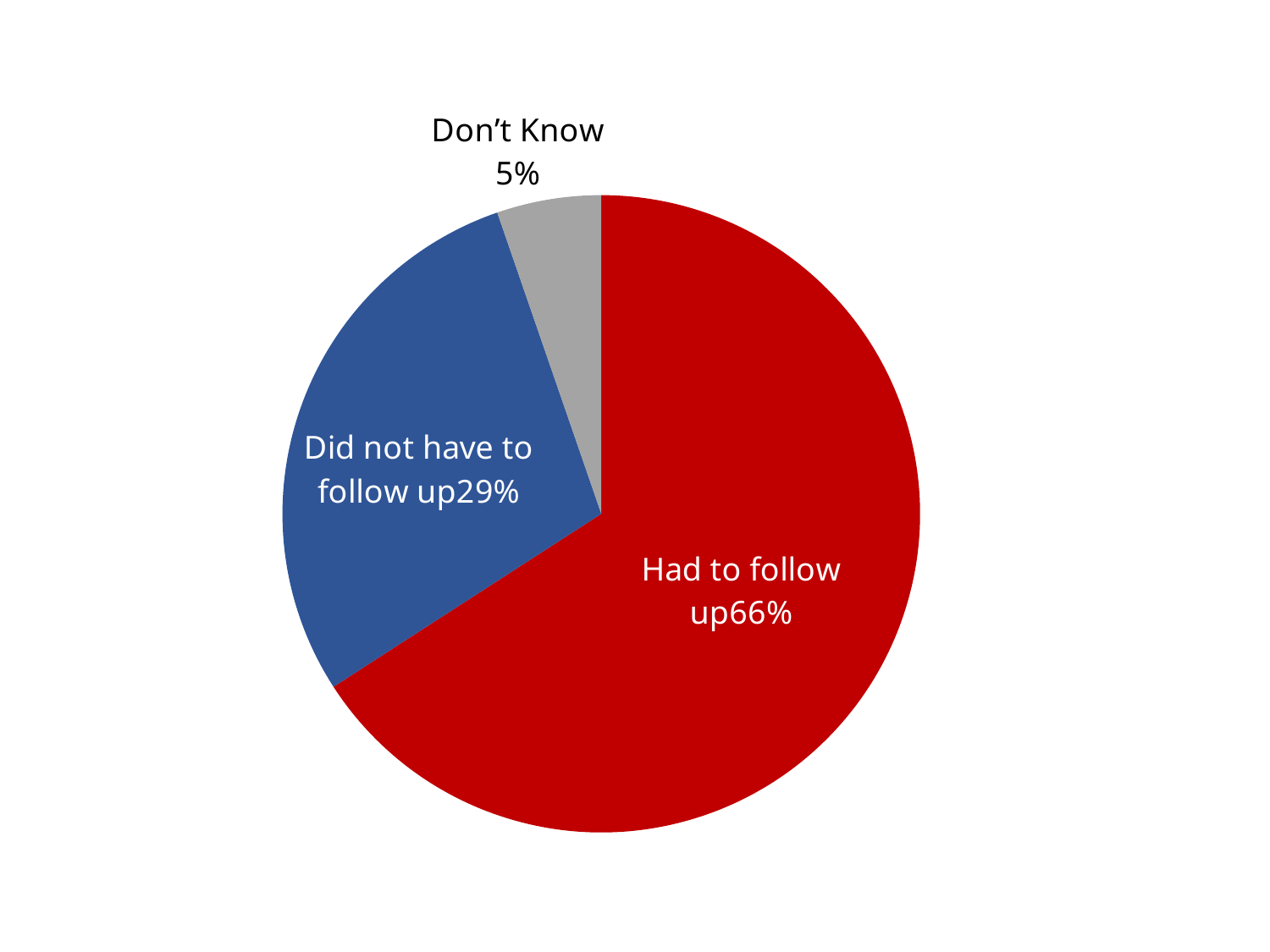
What share of the pie is labelled "Had to follow up"? 66% What colour is the "Had to follow up" slice? Red What share of the pie is labelled "Did not have to follow up"? 29% What is the difference in percentage points between "Had to follow up" and "Did not have to follow up"? 37 Which slice of the pie is the smallest? Don't Know Which is larger, the "Did not have to follow up" slice or the "Don't Know" slice? Did not have to follow up What kind of chart is shown on the slide? Pie chart How many slices does the pie chart have? 3 Which slice of the pie is the largest? Had to follow up What share of the pie is labelled "Don't Know"? 5% What is the difference in percentage points between "Did not have to follow up" and "Don't Know"? 24 What colour is the "Don't Know" slice? Grey